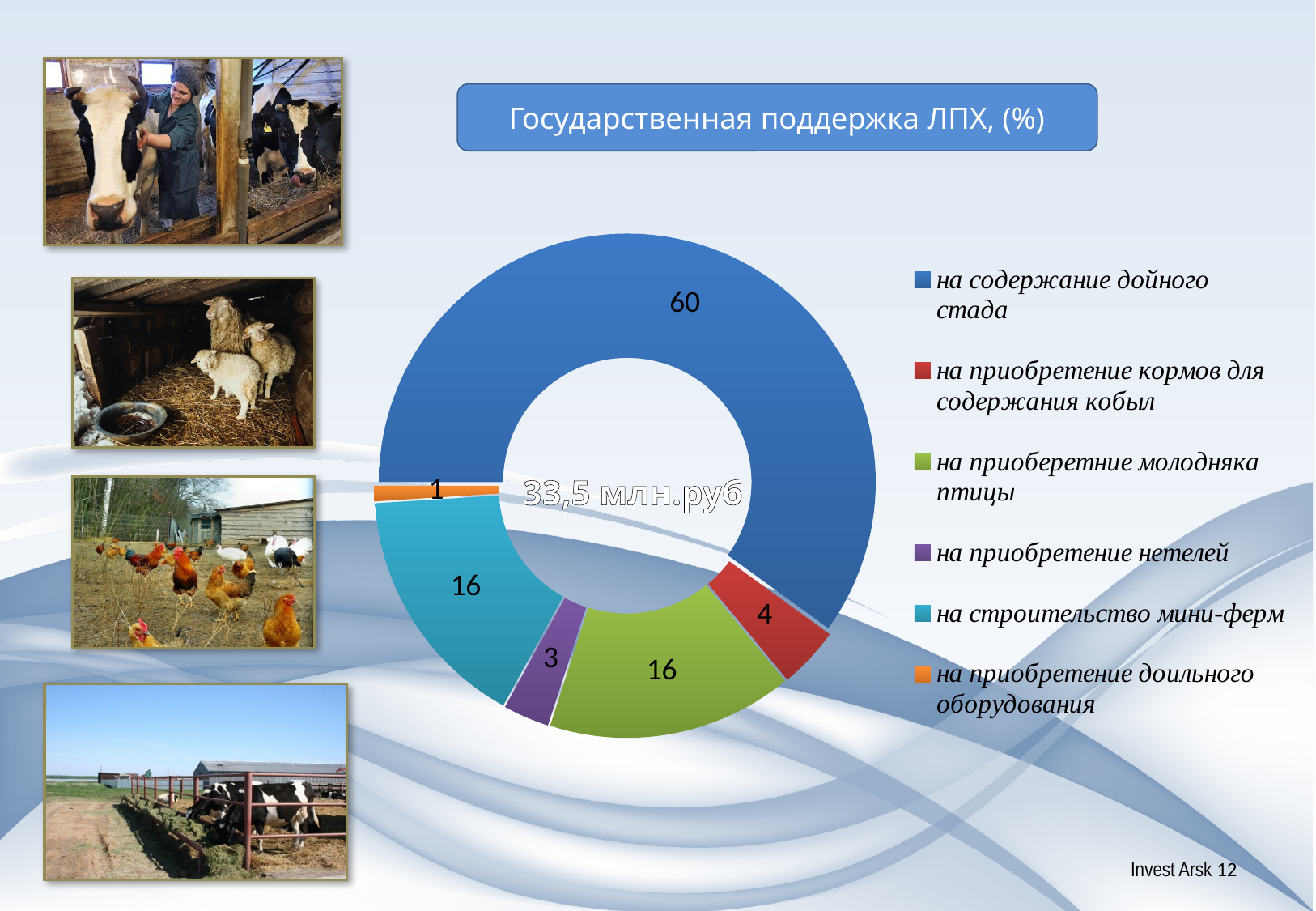
How many categories does the chart show? 6 What value is shown for 'на приобретение нетелей'? 3 What is the title of the chart? Государственная поддержка ЛПХ, (%) What value is shown for 'на содержание дойного стада'? 60 What type of chart is shown on the slide? Doughnut (pie) chart What value is shown for 'на приобретение доильного оборудования'? 1 What value is shown for 'на приобретение кормов для содержания кобыл'? 4 What text is shown in the centre of the doughnut chart? 33,5 млн.руб Which category has the largest share of the chart? на содержание дойного стада What is the difference between the values for 'на содержание дойного стада' and 'на строительство мини-ферм'? 44 Which category has the smallest share of the chart? на приобретение доильного оборудования Which is larger: the value for 'на приобретение кормов для содержания кобыл' or for 'на приобретение нетелей'? на приобретение кормов для содержания кобыл